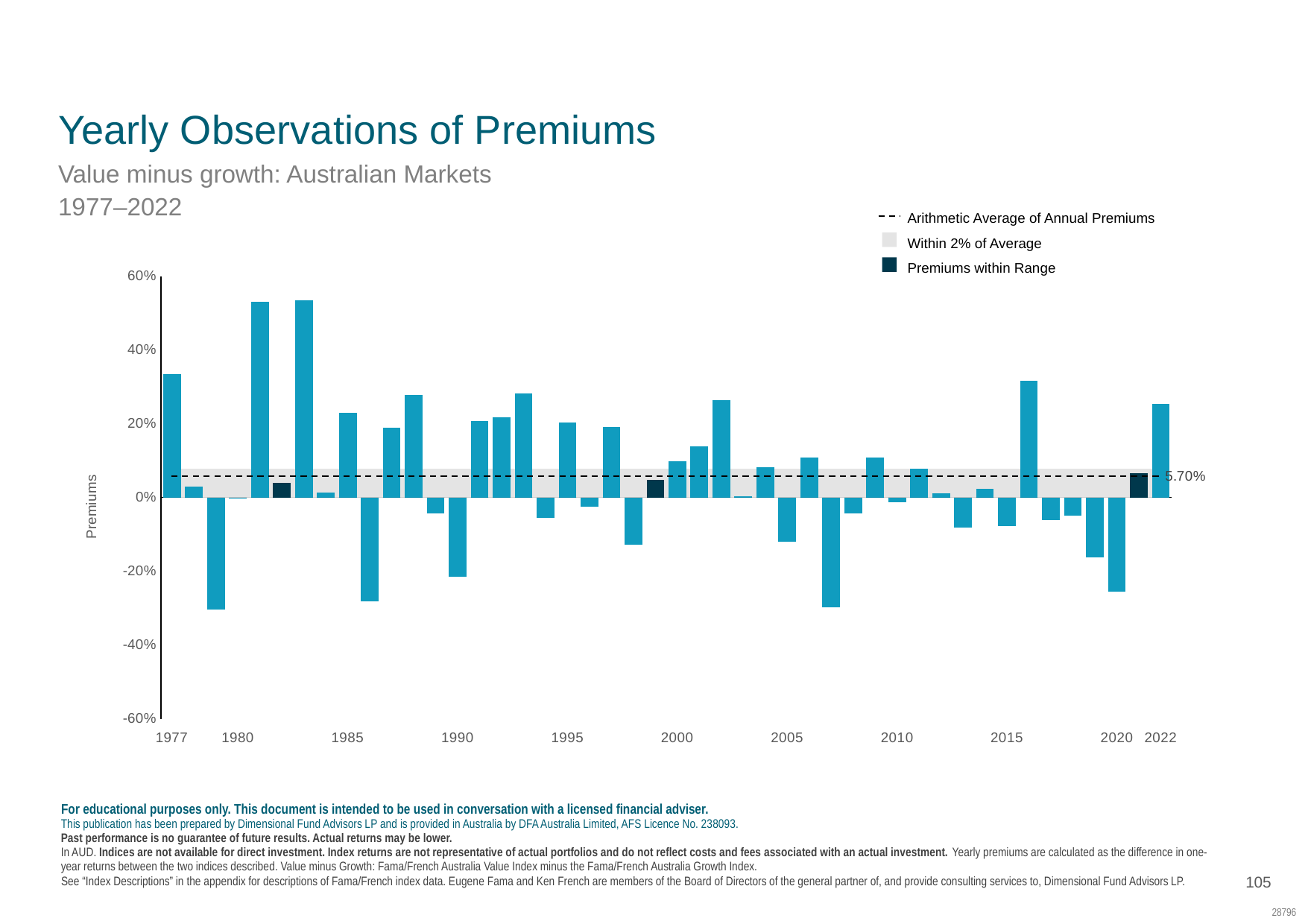
Is the premium for 1990 greater or less than 0%? less What kind of chart is shown on the slide? bar chart What does the dashed horizontal line on the chart represent? Arithmetic Average of Annual Premiums Is the premium for 2005 greater or less than 0%? less Is the premium for 2000 greater or less than 0%? greater What is the arithmetic average of annual premiums shown on the chart? 5.70% Which year has the larger premium, 1977 or 2020? 1977 How many years does the chart cover, according to the date range shown? 46 How many entries does the chart legend list? 3